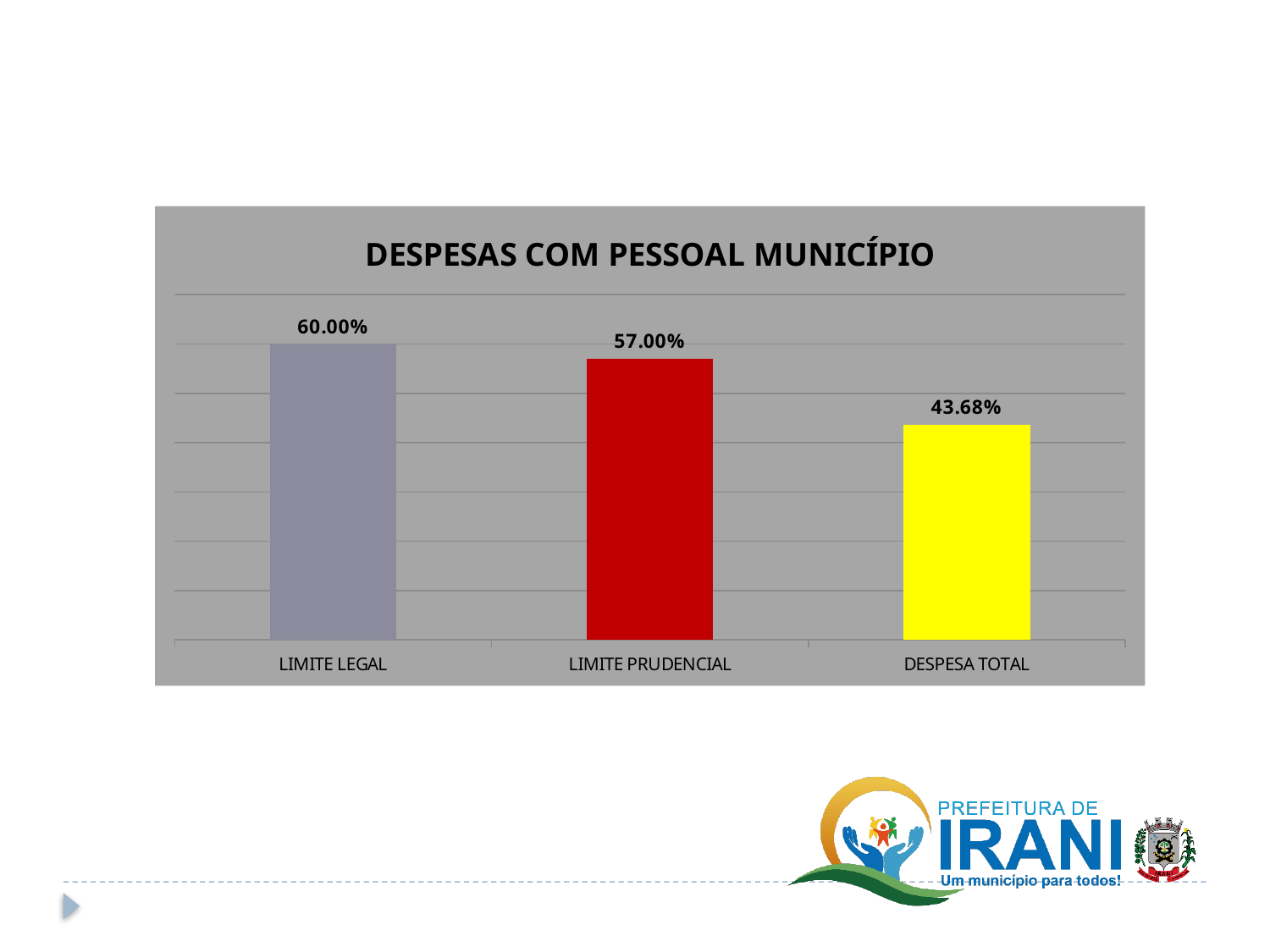
What kind of chart is shown on the slide? bar chart What is the difference between the values for LIMITE PRUDENCIAL and DESPESA TOTAL? 13.32% What is the value for DESPESA TOTAL? 43.68% How many categories are shown in the chart? 3 What is the title of the chart? DESPESAS COM PESSOAL MUNICÍPIO Do the values rise or fall from left to right across the categories? fall Which category has the lowest value? DESPESA TOTAL Which category has the highest value? LIMITE LEGAL Which is larger, the value for LIMITE PRUDENCIAL or the value for DESPESA TOTAL? LIMITE PRUDENCIAL What is the value for LIMITE PRUDENCIAL? 57.00% What is the difference between the values for LIMITE LEGAL and DESPESA TOTAL? 16.32% What is the value for LIMITE LEGAL? 60.00%